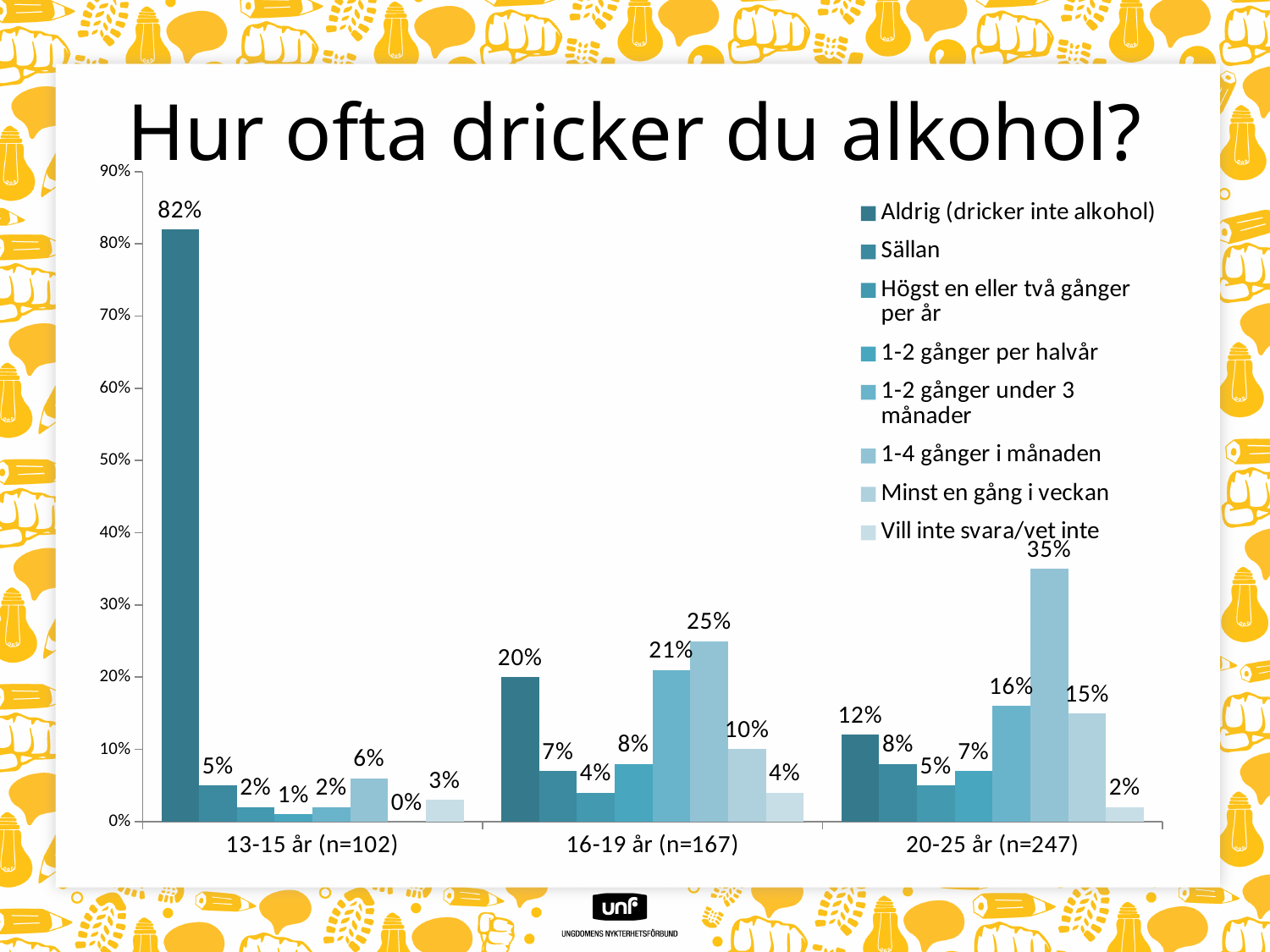
What is the value for "1-4 gånger i månaden" in the 20-25 år (n=247) group? 35% Is the value for "Aldrig (dricker inte alkohol)" in the 13-15 år (n=102) group greater or less than 80%? greater Which series has the lowest value in the 13-15 år (n=102) group? Minst en gång i veckan What is the value for "Minst en gång i veckan" in the 16-19 år (n=167) group? 10% How many series does the legend list? 8 What is the title of the chart? Hur ofta dricker du alkohol? How many age groups are shown on the x axis? 3 Which series has the highest value in the 16-19 år (n=167) group? 1-4 gånger i månaden What kind of chart is shown on the slide? Bar chart What is the value for "Aldrig (dricker inte alkohol)" in the 13-15 år (n=102) group? 82% What is the difference between the "Aldrig (dricker inte alkohol)" values for the 13-15 år (n=102) and 16-19 år (n=167) groups? 62 percentage points Which is larger: "Minst en gång i veckan" for 20-25 år (n=247) or "Minst en gång i veckan" for 16-19 år (n=167)? 20-25 år (n=247)